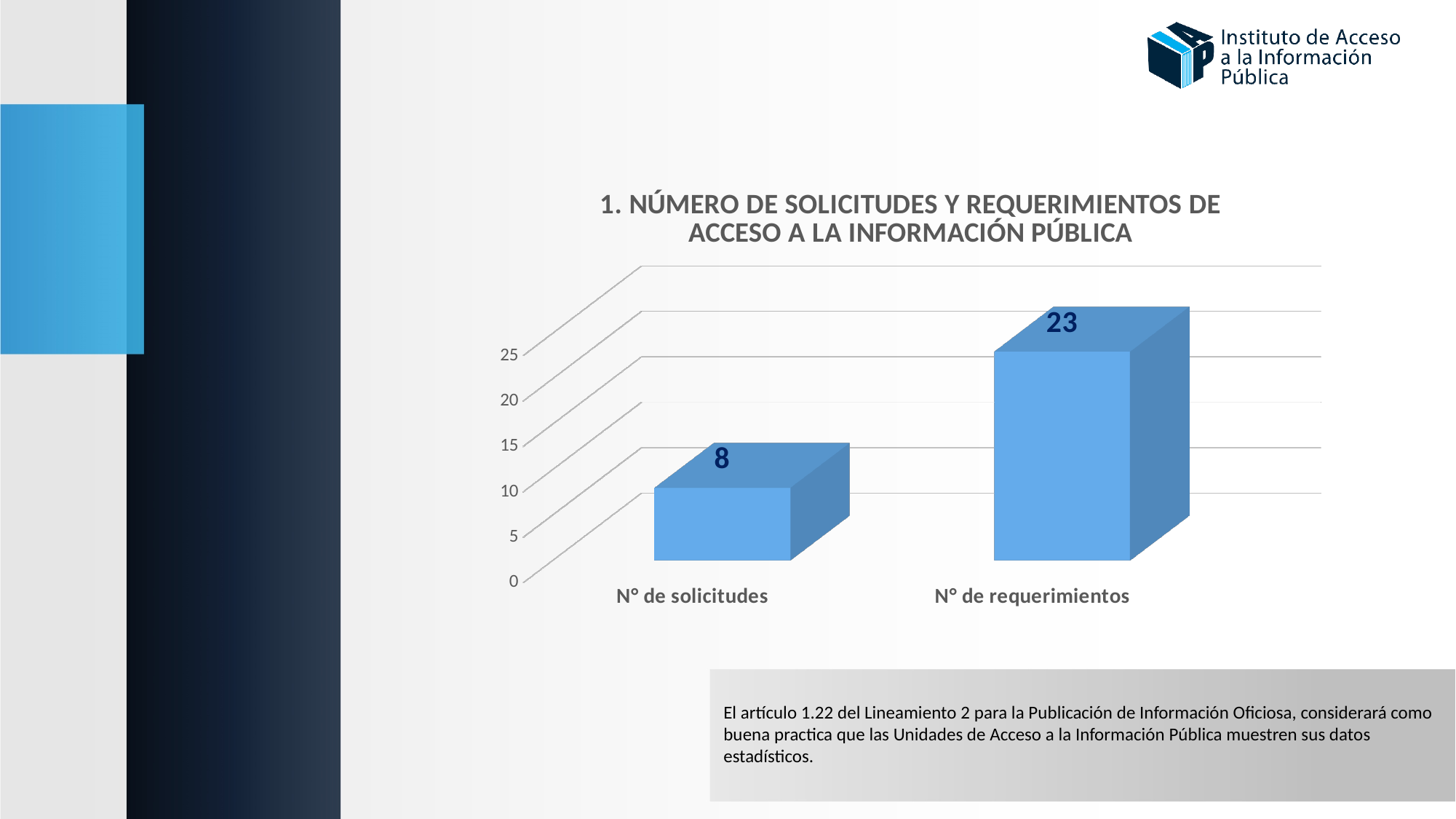
What is the difference between N° de requerimientos and N° de solicitudes? 15 Which category has the lowest value? N° de solicitudes Which is larger, N° de solicitudes or N° de requerimientos? N° de requerimientos Is the value for N° de solicitudes greater or less than 10? less Is the value for N° de requerimientos greater or less than 20? greater What is the title of the chart? 1. NÚMERO DE SOLICITUDES Y REQUERIMIENTOS DE ACCESO A LA INFORMACIÓN PÚBLICA Which category has the highest value? N° de requerimientos How many categories are shown in the chart? 2 What is the highest value shown on the vertical axis? 25 What kind of chart is shown on the slide? Bar chart What is the value for N° de requerimientos? 23 What is the value for N° de solicitudes? 8